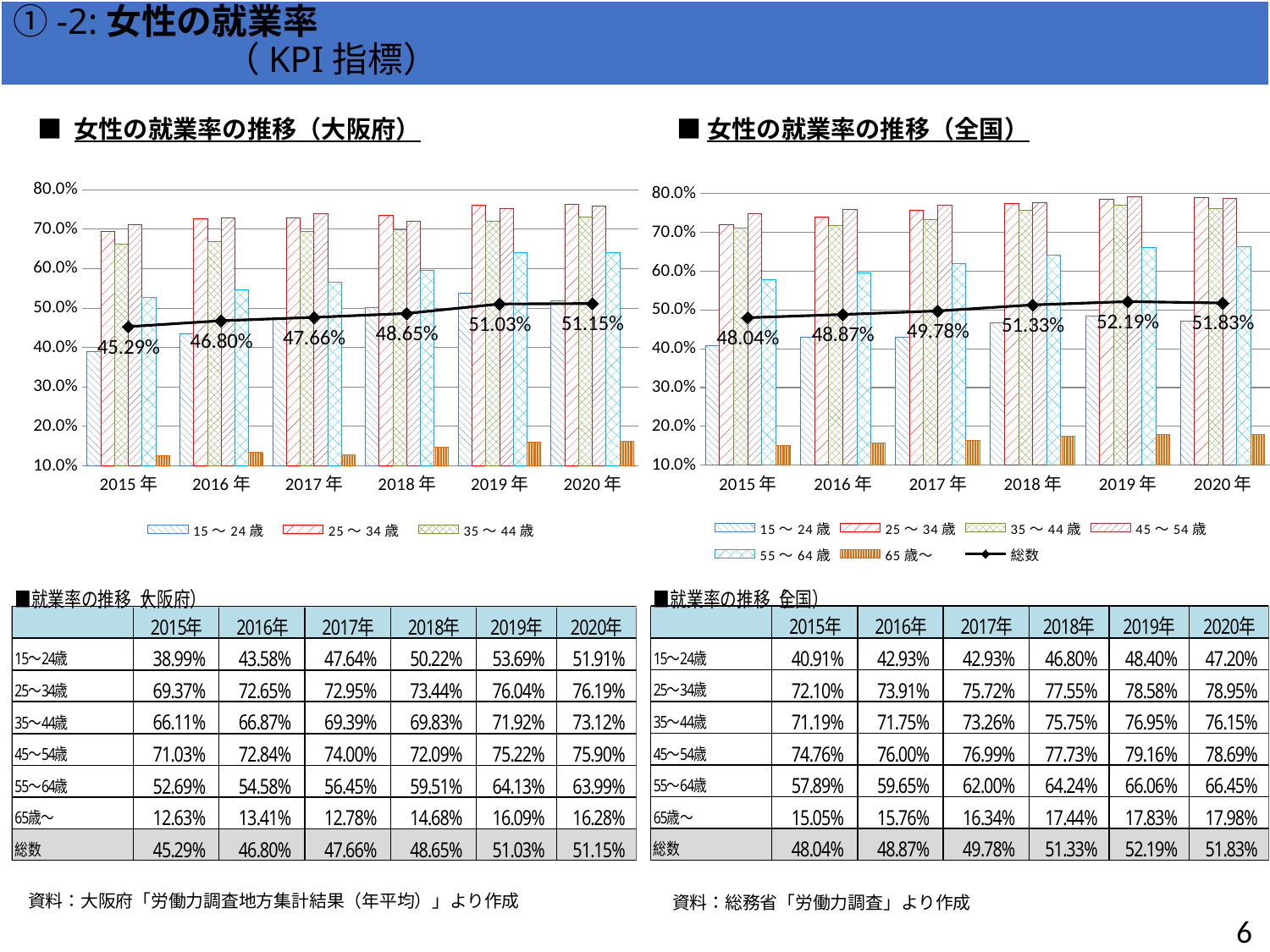
In the left chart (大阪府), is the value for 65歳～ in 2015年 greater or less than 20.0%? less How many series does the legend of the right chart (全国) list? 7 In the left chart (大阪府), what is the difference between the 総数 values for 2020年 and 2015年? 5.86 percentage points How many years are shown on the x axis of the left chart (大阪府)? 6 In the right chart (全国), which year has the highest 総数 value? 2019年 In the left chart (大阪府), does the 総数 line generally rise or fall from 2015年 to 2020年? rise In the left chart (大阪府), which year has the highest 総数 value? 2020年 In the right chart (女性の就業率の推移（全国）), what is the 総数 value for 2020年? 51.83% In the left chart (女性の就業率の推移（大阪府）), what is the 総数 value for 2015年? 45.29% What kind of chart is the right chart (全国)? bar chart with a line In the right chart (全国), which year has the lowest 総数 value? 2015年 In the right chart (全国), which year has the larger 総数 value, 2019年 or 2020年? 2019年